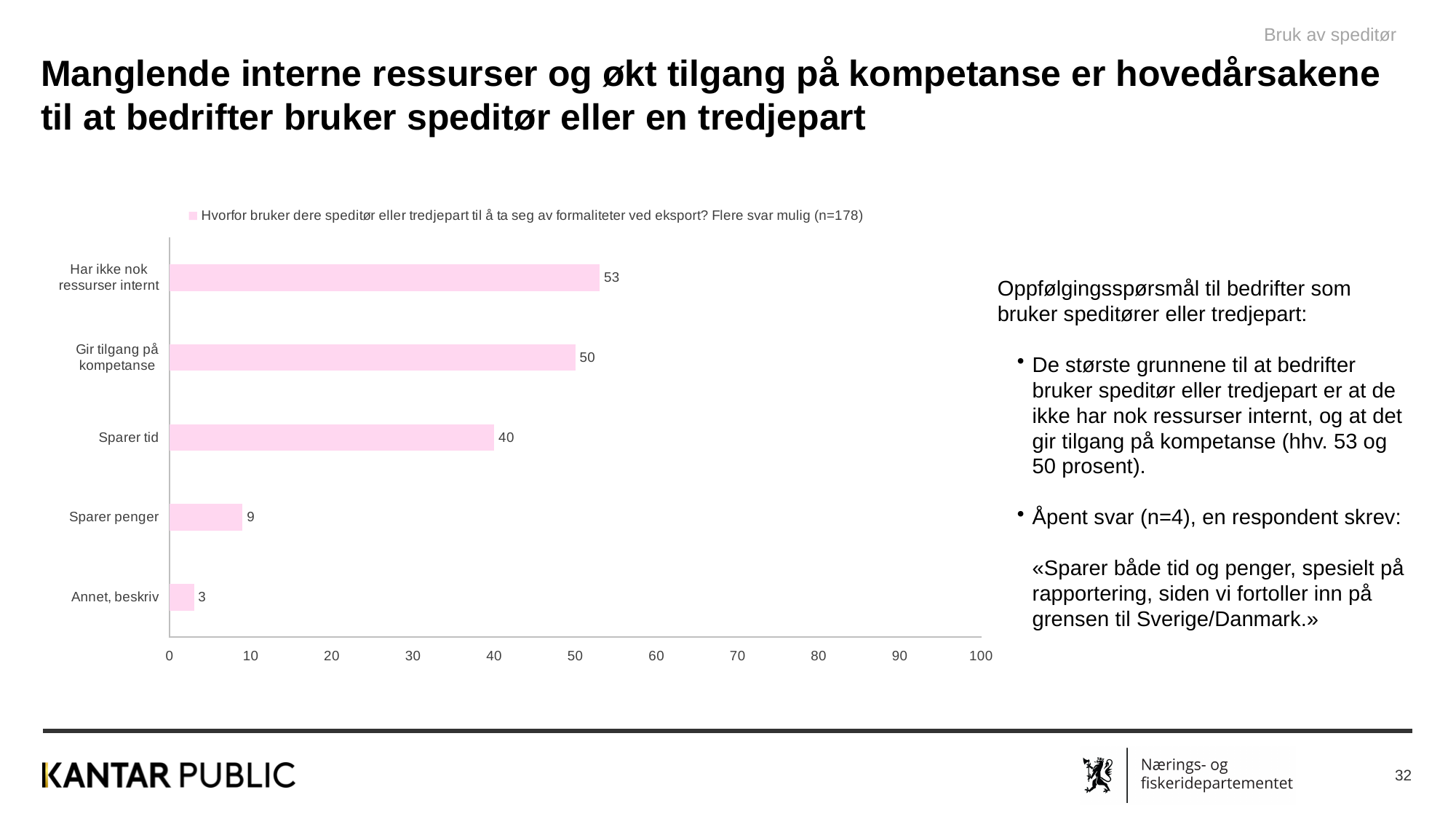
What is the difference between the values for "Sparer tid" and "Sparer penger"? 31 Which category has the highest value? Har ikke nok ressurser internt What is the value for "Annet, beskriv"? 3 What is the value for "Sparer penger"? 9 Which is larger, the value for "Gir tilgang på kompetanse" or the value for "Sparer tid"? Gir tilgang på kompetanse What is the maximum value shown on the x axis of the chart? 100 What is the value for "Gir tilgang på kompetanse"? 50 What is the value for "Sparer tid"? 40 What is the value for "Har ikke nok ressurser internt"? 53 How many categories are shown in the chart? 5 Which category has the lowest value? Annet, beskriv What kind of chart is shown on the slide? Bar chart